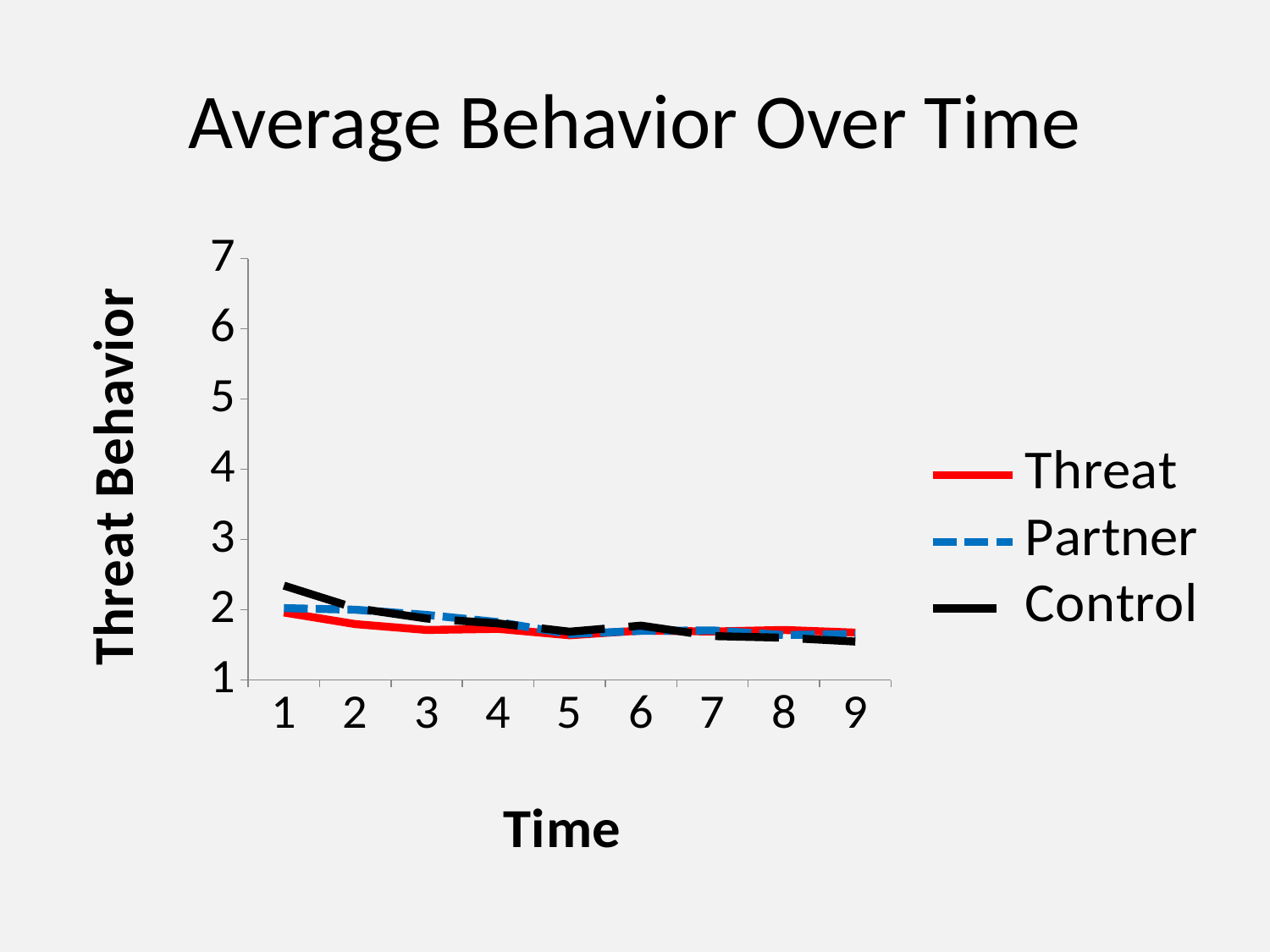
Is the value for Control at time 9 greater or less than 2? less Does the Control series generally rise or fall from time 1 to time 9? fall Which series has the highest value at time 1? Control What kind of chart is shown on the slide? line chart At time 1, which is larger, the value for Control or the value for Threat? Control Is the value for Partner at time 5 greater or less than 3? less Is the value for Threat at time 3 greater or less than 2? less How many time points are plotted along the x axis? 9 What is the label of the y axis? Threat Behavior What is the title of the chart? Average Behavior Over Time How many series does the legend list? 3